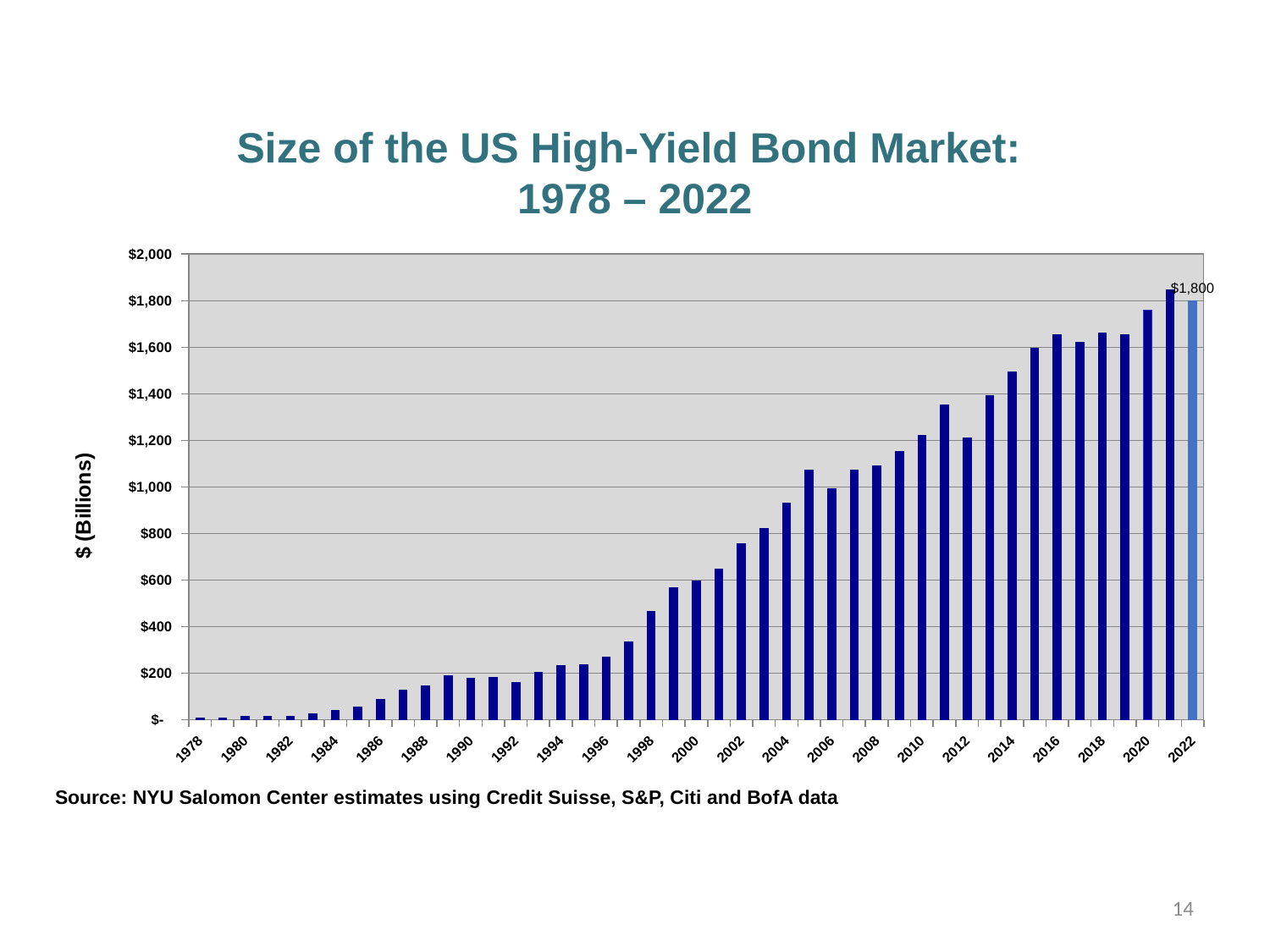
Is the value for 2020 greater or less than $1,800? less Which is larger, the value for 2011 or the value for 2012? 2011 How many years (bars) are plotted on the chart? 45 What is the value shown for 2022? $1,800 What kind of chart is shown on the slide? Bar chart Which year has the lowest value on the chart? 1978 Which is larger, the value for 2005 or the value for 2006? 2005 Overall, do the values rise or fall from 1978 to 2022? Rise What is the label on the vertical axis of the chart? $ (Billions) Is the value for 2016 greater or less than $1,600? greater Is the value for 2004 greater or less than $800? greater